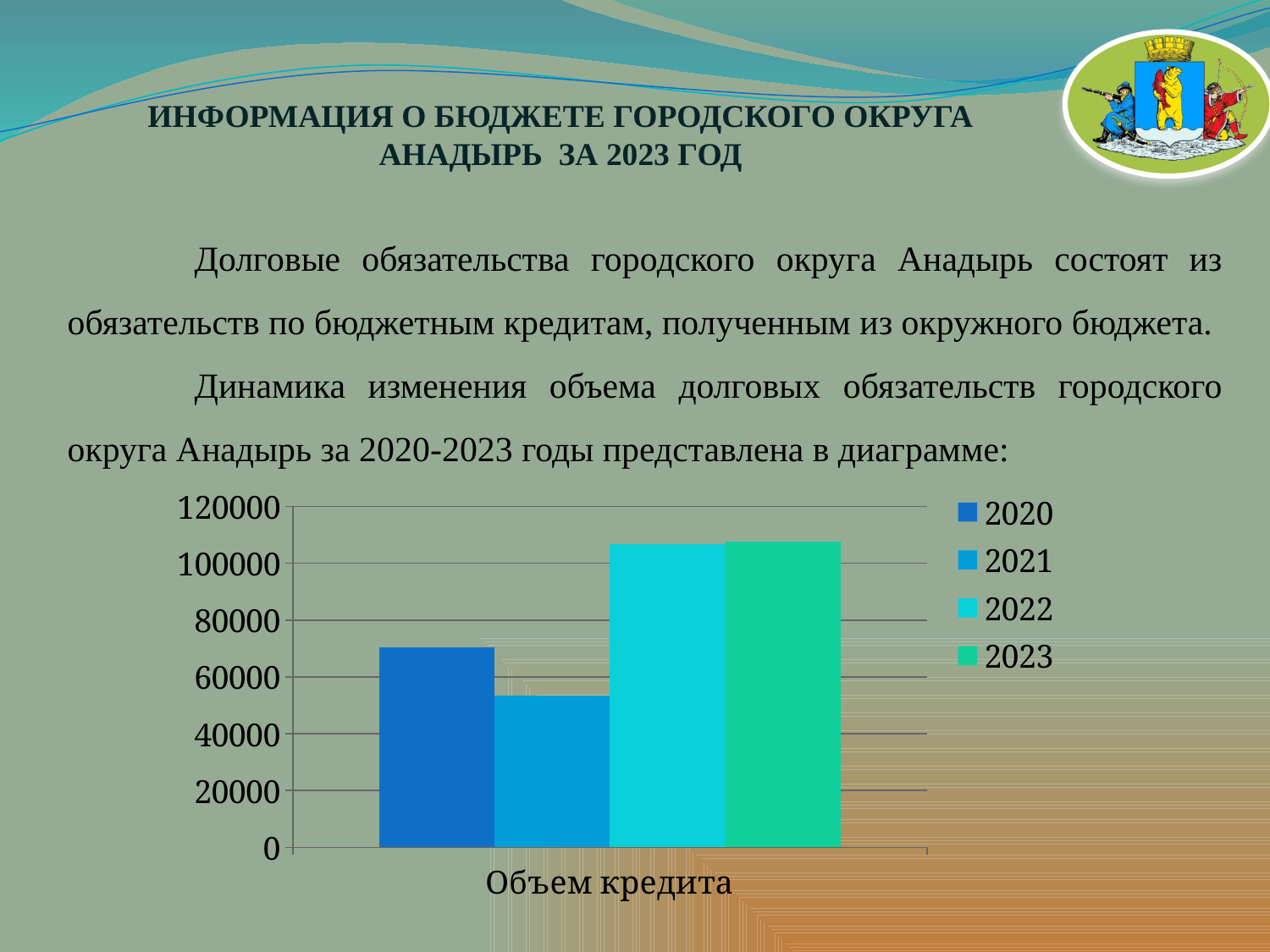
Is the value for 2023 greater or less than 100000? greater Which is larger, the value for 2020 or the value for 2022? 2022 How many series does the chart legend list? 4 Which is larger, the value for 2020 or the value for 2021? 2020 Is the value for 2021 greater or less than 60000? less How many categories are shown on the x axis of the chart? 1 What is the category label shown on the x axis of the chart? Объем кредита Which year has the lowest value in the chart? 2021 What is the highest value shown on the chart's vertical axis? 120000 Is the value for 2020 greater or less than 60000? greater What kind of chart is shown on the slide? bar chart